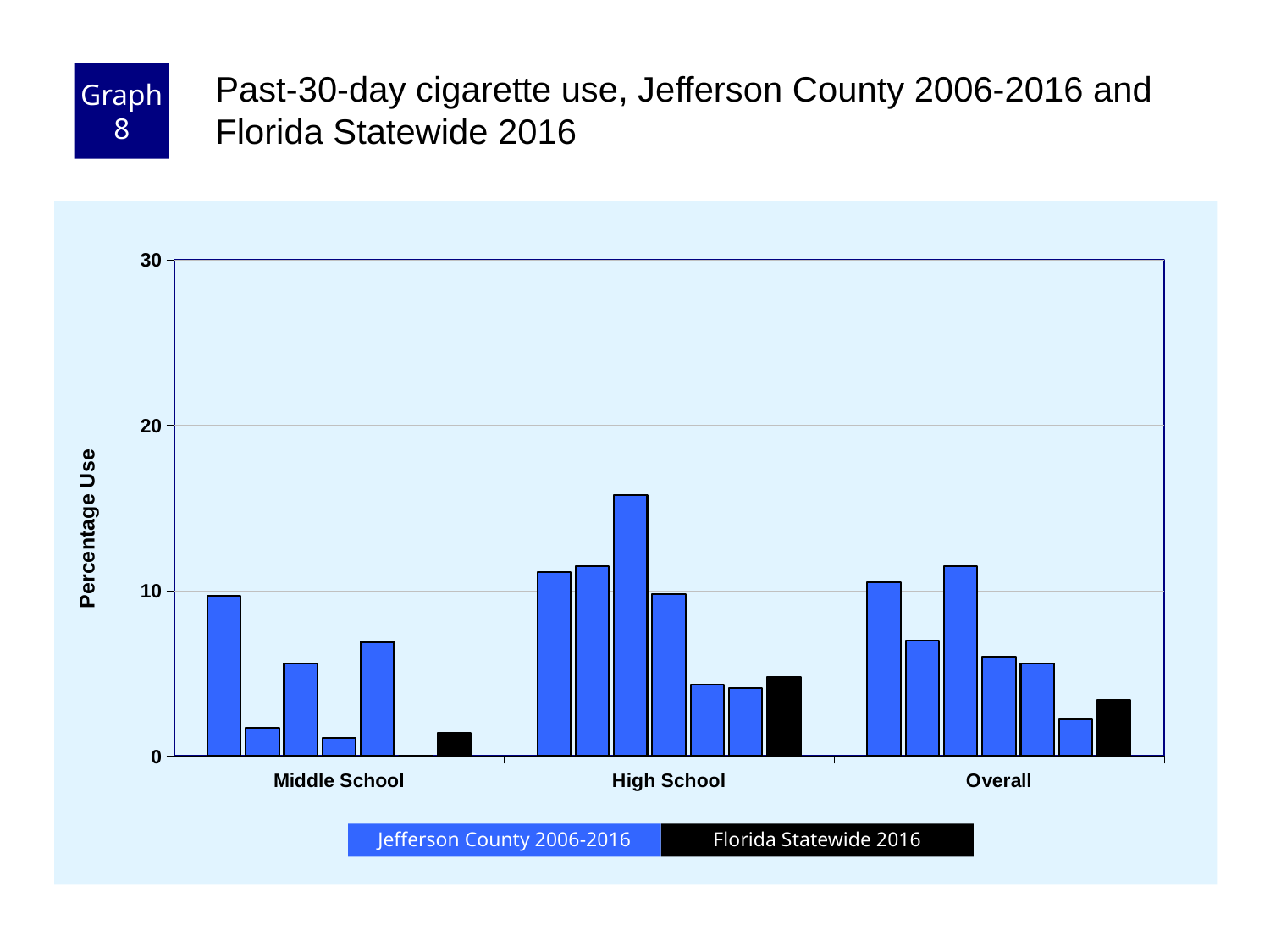
Which series is drawn in black? Florida Statewide 2016 What is the label on the y axis? Percentage Use Which category has the lowest Florida Statewide 2016 value? Middle School Is the tallest bar in the whole chart greater or less than 20? less Is the Florida Statewide 2016 value for Middle School greater or less than 10? less Is the Florida Statewide 2016 value for High School greater or less than 10? less Which category contains the tallest bar in the chart? High School What kind of chart is shown on the slide? bar chart How many categories are shown along the x axis? 3 Is the Florida Statewide 2016 value larger for High School or for Middle School? High School How many series does the legend list? 2